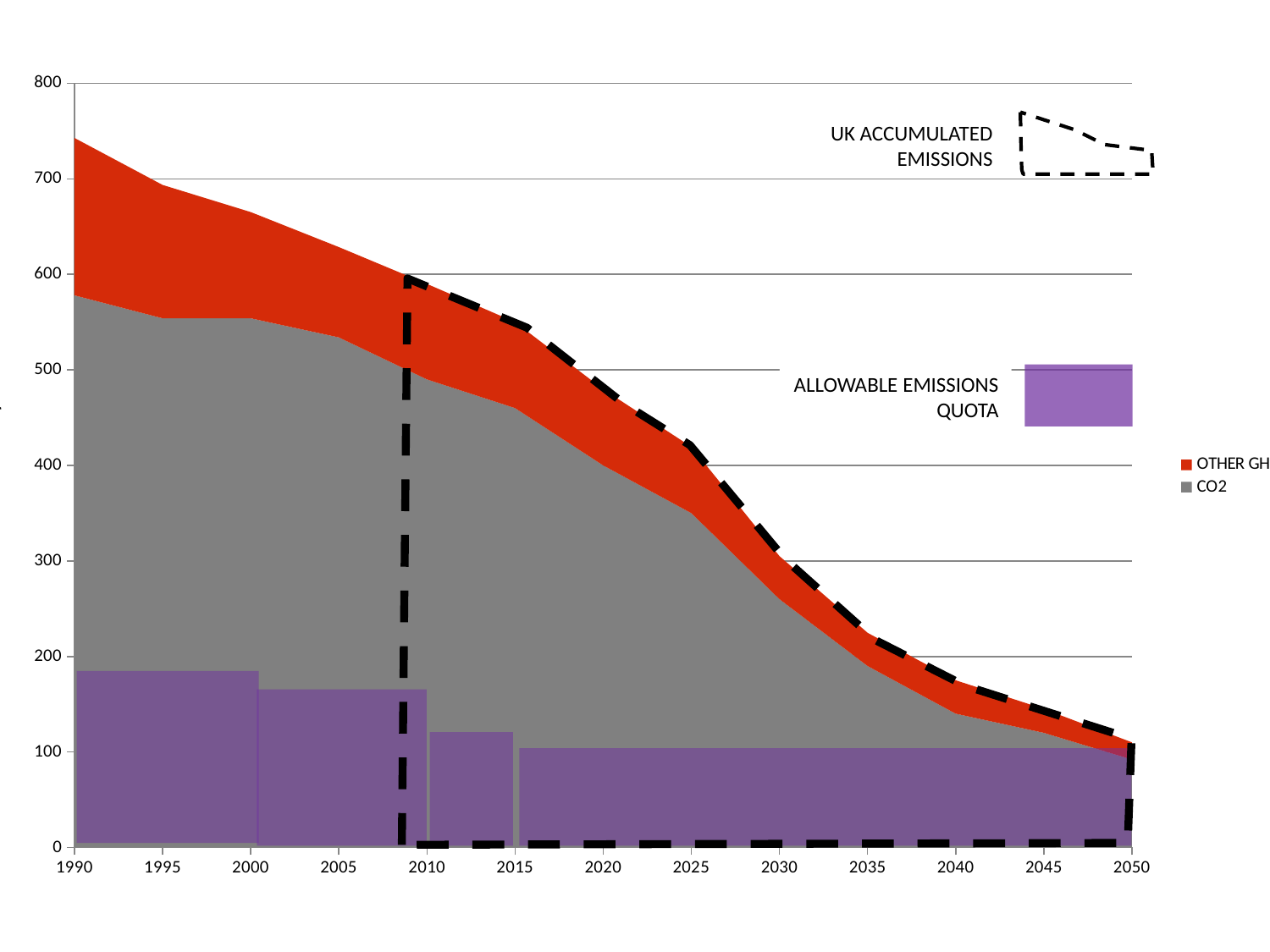
Is the top of the stacked area (CO2 plus OTHER GH) in 2010 greater or less than 500? greater Do the CO2 values rise or fall from 1990 to 2050? fall Is the top of the stacked area (CO2 plus OTHER GH) in 2030 greater or less than 400? less What label is given to the purple shaded area? ALLOWABLE EMISSIONS QUOTA Is the top of the stacked area (CO2 plus OTHER GH) in 1990 greater or less than 700? greater Which series is shown in red? OTHER GH What kind of chart is shown on the slide? area chart How many series does the legend list? 2 How many year labels are shown on the x axis? 13 Which is larger, the CO2 value in 1990 or the CO2 value in 2050? 1990